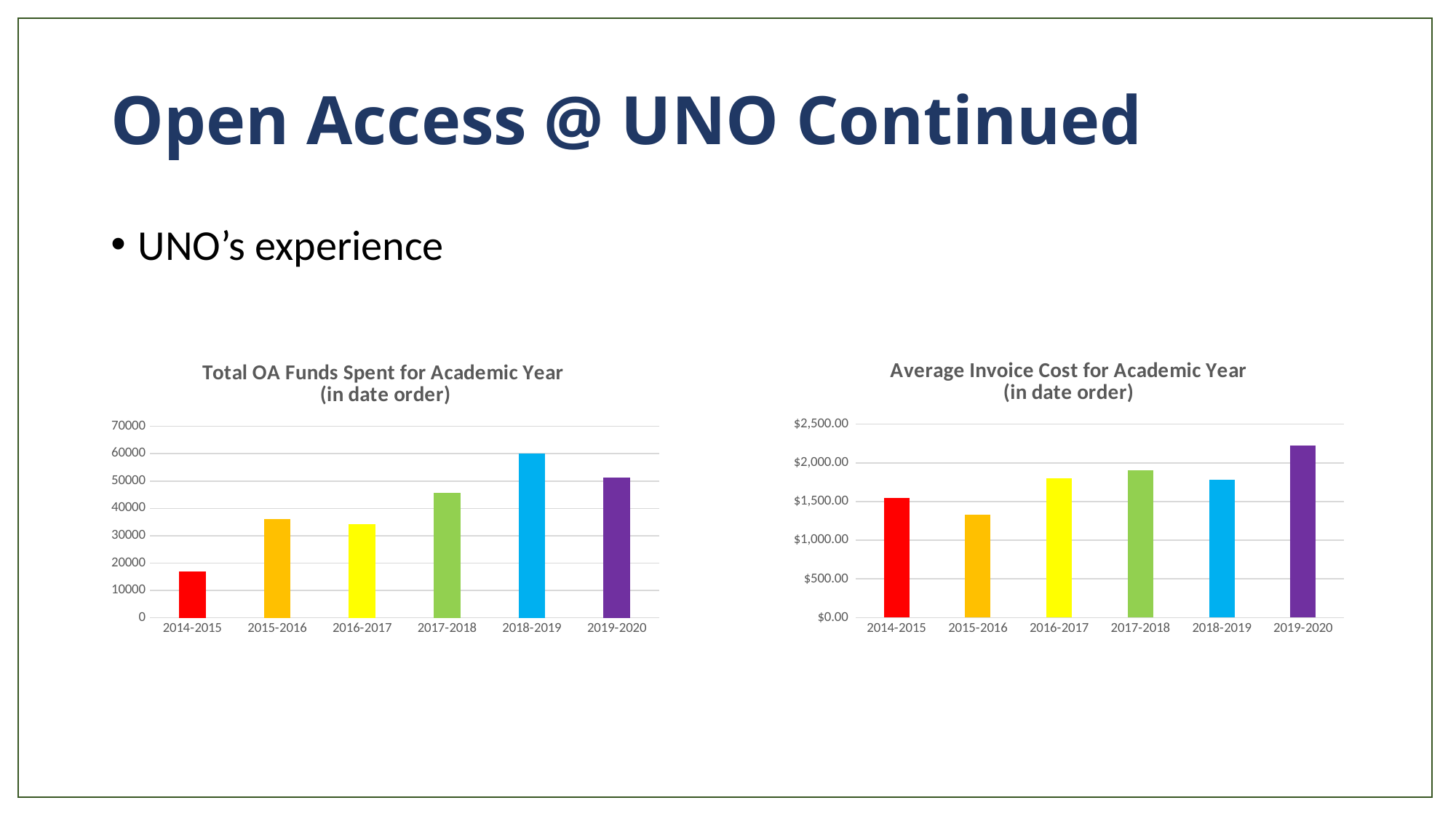
What kind of chart is the "Total OA Funds Spent for Academic Year" chart? bar chart How many academic years are shown on the "Total OA Funds Spent for Academic Year" chart? 6 On the "Total OA Funds Spent for Academic Year" chart, is the value for 2014-2015 greater or less than 20000? less On the "Total OA Funds Spent for Academic Year" chart, which is larger, the value for 2017-2018 or the value for 2016-2017? 2017-2018 On the "Average Invoice Cost for Academic Year" chart, is the value for 2019-2020 greater or less than $2,000.00? greater On the "Total OA Funds Spent for Academic Year" chart, which academic year has the highest value? 2018-2019 On the "Average Invoice Cost for Academic Year" chart, which academic year has the highest value? 2019-2020 On the "Total OA Funds Spent for Academic Year" chart, which academic year has the lowest value? 2014-2015 On the "Average Invoice Cost for Academic Year" chart, which academic year has the lowest value? 2015-2016 What is the title of the chart on the right side of the slide? Average Invoice Cost for Academic Year (in date order) On the "Average Invoice Cost for Academic Year" chart, is the value for 2015-2016 greater or less than $1,500.00? less